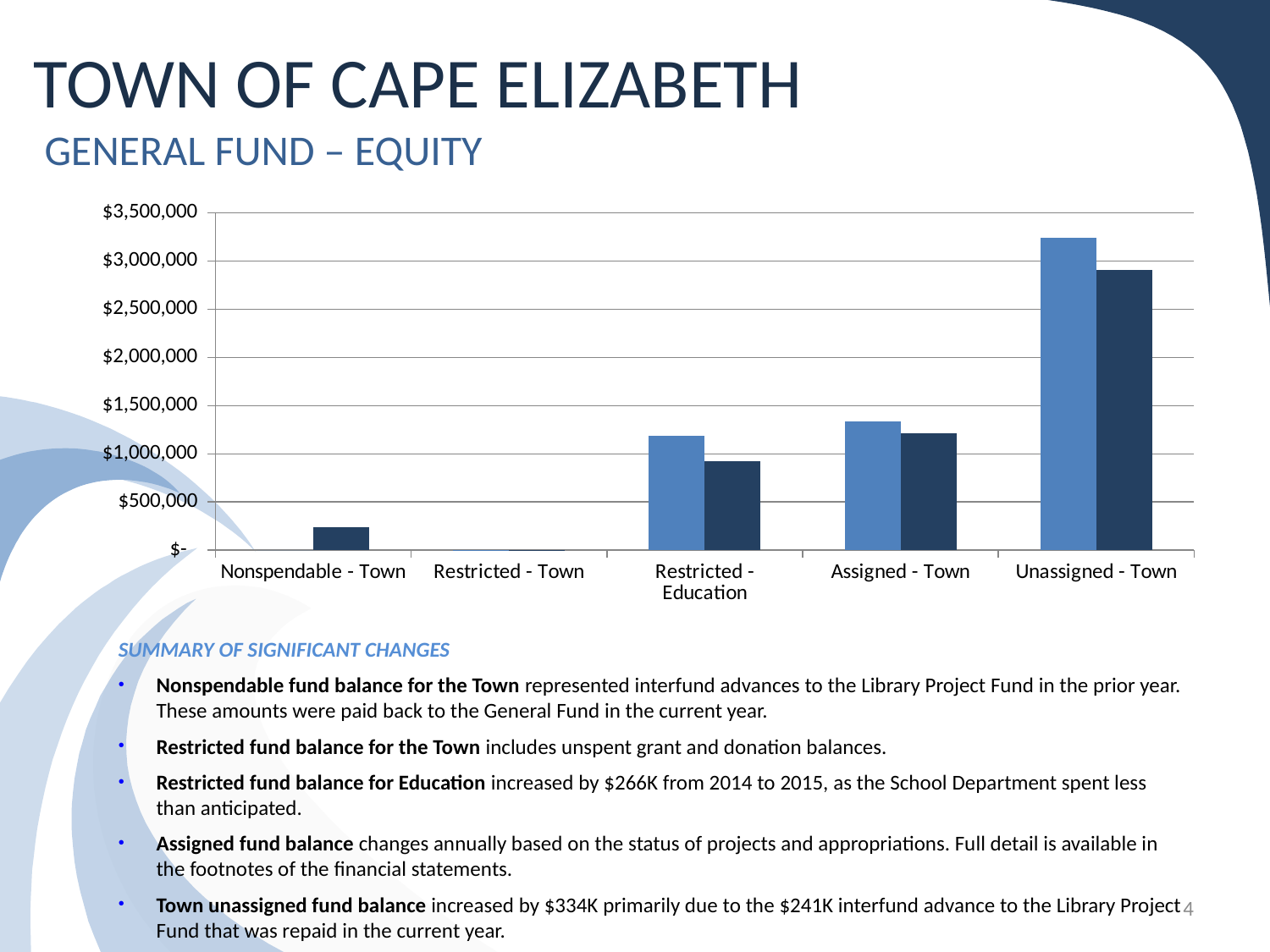
Is the light blue bar for Unassigned - Town greater or less than $3,000,000? greater Is the dark blue bar for Nonspendable - Town greater or less than $500,000? less Which category has the smallest bars in the chart? Restricted - Town Is the light blue bar for Restricted - Education greater or less than $1,000,000? greater Which has the larger light blue bar, Restricted - Education or Assigned - Town? Assigned - Town What kind of chart is shown on the slide? bar chart How many categories are shown on the x axis of the chart? 5 For Unassigned - Town, which bar is taller, the light blue or the dark blue one? light blue What is the highest value labelled on the y axis of the chart? $3,500,000 Which category has the tallest bars in the chart? Unassigned - Town